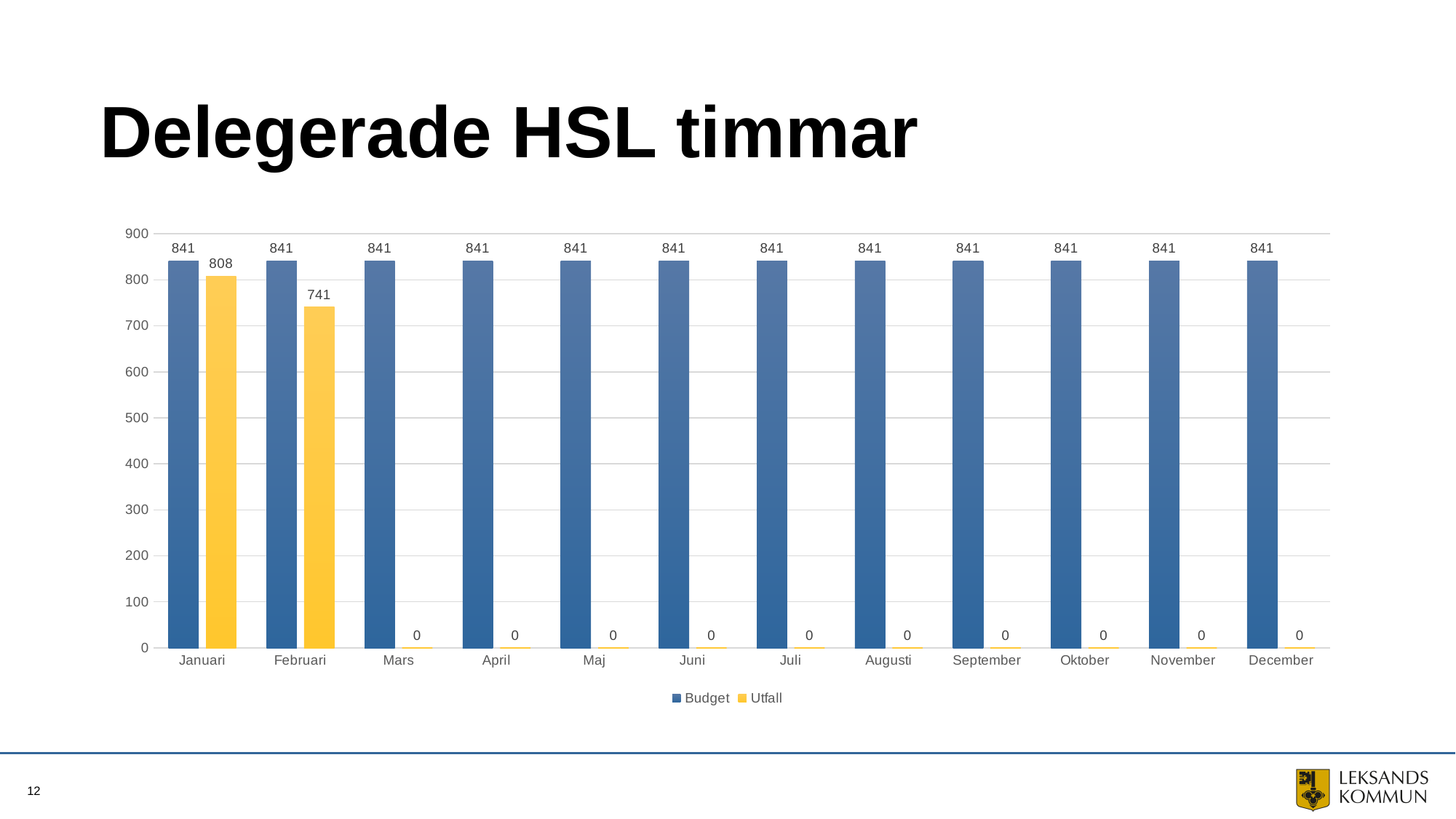
Which is larger for Februari, Budget or Utfall? Budget Which month has the highest Utfall value? Januari How many series does the legend list? 2 What is the Utfall value for Juli? 0 What kind of chart is shown on the slide? Bar chart What is the Utfall value for Februari? 741 How many months are shown on the x axis? 12 What is the difference between the Budget and Utfall values for Januari? 33 What is the difference between the Budget and Utfall values for Februari? 100 What is the Budget value for Mars? 841 What is the title of the slide? Delegerade HSL timmar What is the Utfall value for Januari? 808